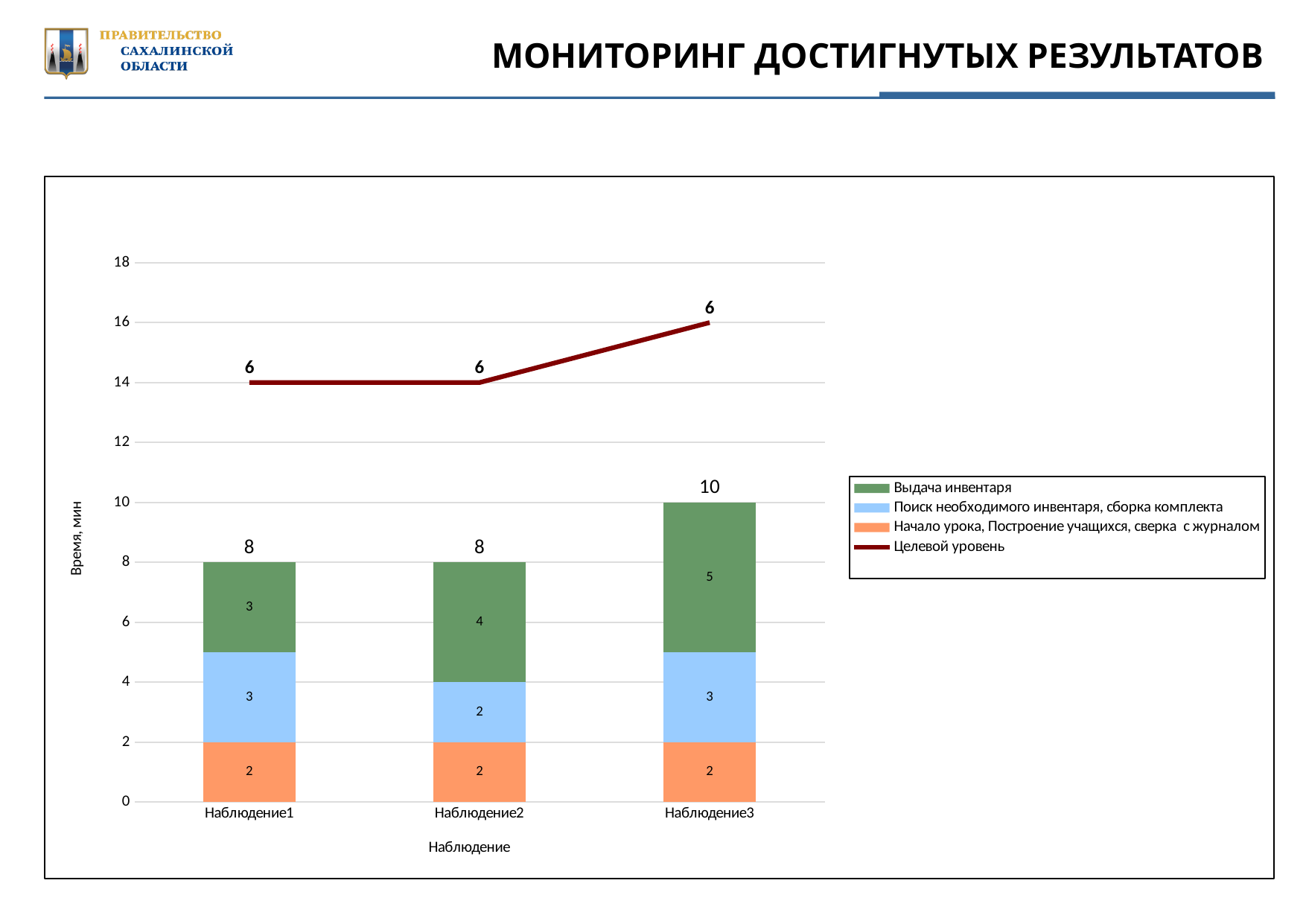
Which category has the highest stacked bar total? Наблюдение3 How many series does the legend list? 4 How many categories are shown on the x axis? 3 What is the value of Начало урока, Построение учащихся, сверка с журналом for Наблюдение1? 2 What is the value of Поиск необходимого инвентаря, сборка комплекта for Наблюдение2? 2 What is the total of the stacked bar for Наблюдение3? 10 What is the label on the y axis? Время, мин What type of chart is shown on the slide? stacked bar chart with a line Does the Выдача инвентаря value rise or fall from Наблюдение1 to Наблюдение3? rise Which is larger: the Выдача инвентаря value for Наблюдение2 or for Наблюдение1? Наблюдение2 What is the difference between the Выдача инвентаря values for Наблюдение3 and Наблюдение1? 2 What is the value of Выдача инвентаря for Наблюдение3? 5